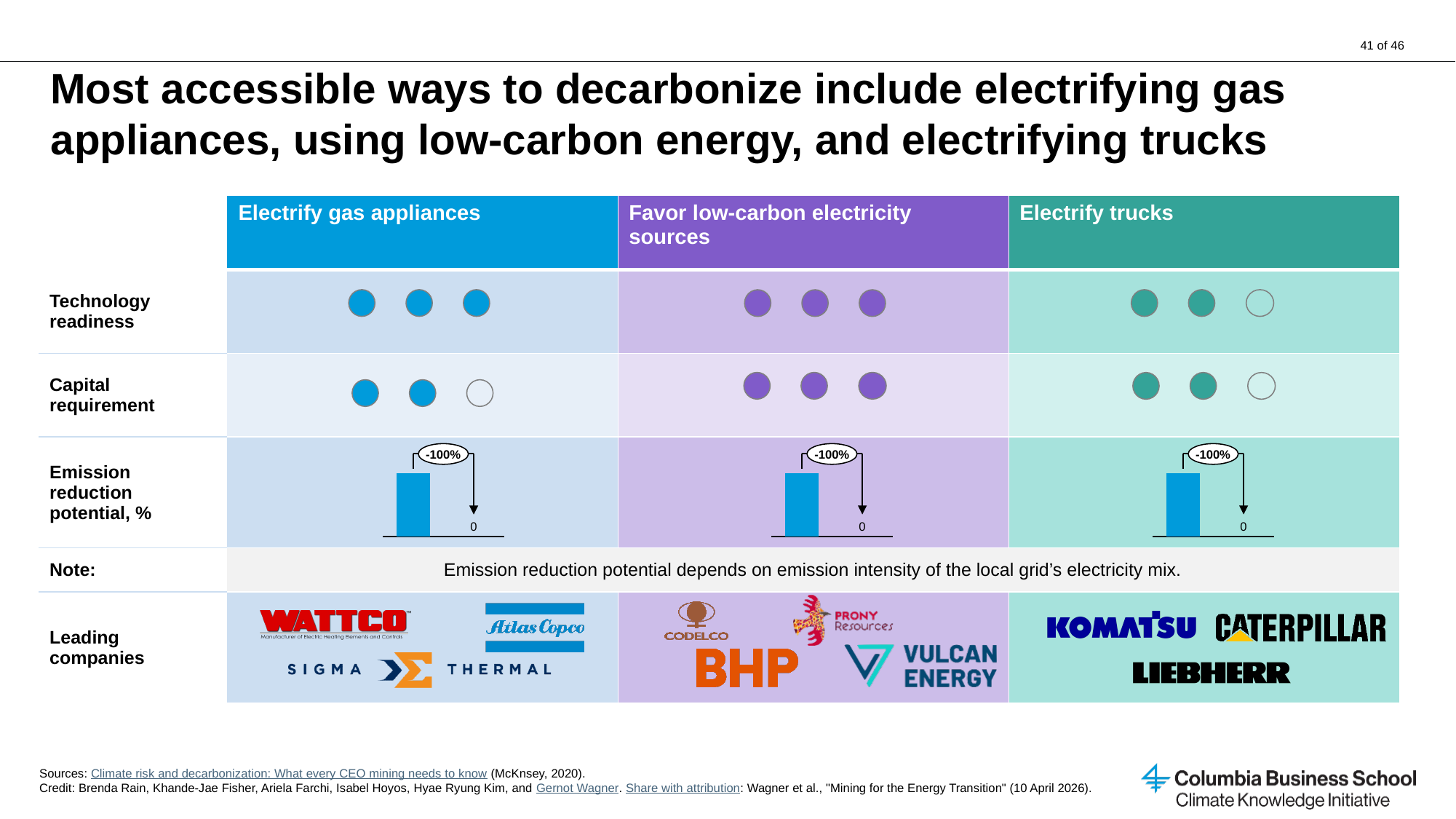
How many bars are plotted in the Emission reduction potential chart for Favor low-carbon electricity sources? 1 What kind of chart is used in the Emission reduction potential row? Bar chart Which column has the fewest filled circles for Capital requirement? Electrify gas appliances and Electrify trucks (2 each) In the Emission reduction potential chart for Electrify trucks, what value does the arrow point to? 0 How many filled circles are shown for Technology readiness under Electrify trucks? 2 What emission reduction potential is shown for Favor low-carbon electricity sources? -100% Is the emission reduction potential for Electrify gas appliances the same as for Electrify trucks? Yes, both -100% What emission reduction potential is shown for Electrify gas appliances? -100% How many small bar charts appear in the Emission reduction potential row? 3 What unit is the Emission reduction potential row expressed in? % How many filled circles are shown for Capital requirement under Favor low-carbon electricity sources? 3 What emission reduction potential is shown for Electrify trucks? -100%